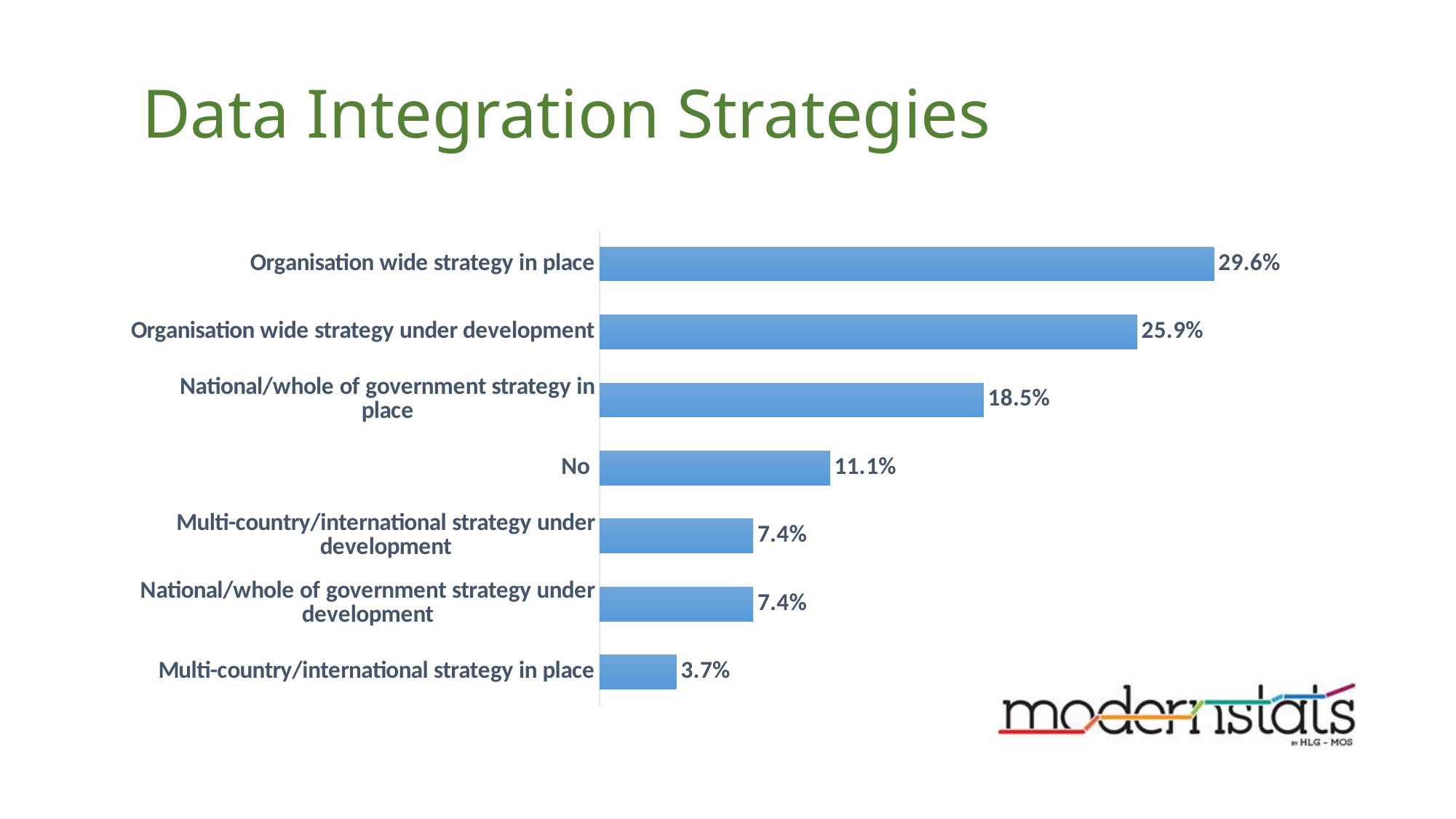
Which category has the lowest value? Multi-country/international strategy in place Which category has the highest value? Organisation wide strategy in place How many categories are shown in the chart? 7 What is the value for "Multi-country/international strategy in place"? 3.7% What is the title of the slide? Data Integration Strategies Which is larger: "Organisation wide strategy under development" or "National/whole of government strategy in place"? Organisation wide strategy under development What is the value for "Organisation wide strategy in place"? 29.6% What is the difference between "Organisation wide strategy in place" and "Organisation wide strategy under development"? 3.7% What kind of chart is shown on the slide? Bar chart What is the value for "National/whole of government strategy in place"? 18.5% What is the difference between "National/whole of government strategy in place" and "No"? 7.4% What is the value for "No"? 11.1%